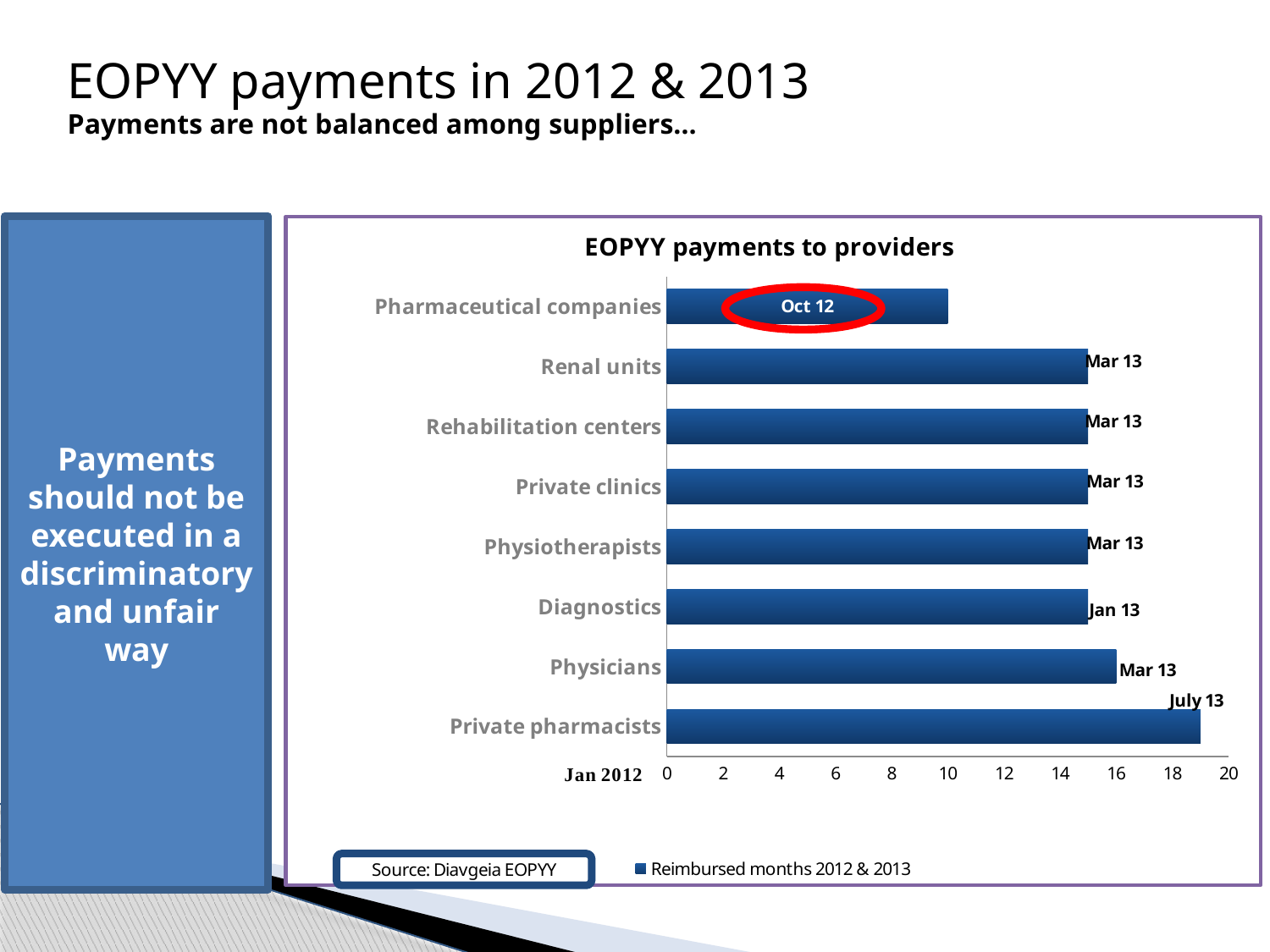
How many provider categories are shown in the chart? 8 Which provider category has the shortest bar? Pharmaceutical companies Which has a larger value, Physicians or Pharmaceutical companies? Physicians What data label is shown on the bar for Pharmaceutical companies? Oct 12 What type of chart is shown on the slide? Bar chart What is the title of the chart? EOPYY payments to providers What data label is shown on the bar for Private pharmacists? July 13 How many series does the legend list? 1 Is the value for Private pharmacists greater or less than 18? greater Which provider category has the longest bar? Private pharmacists What data label is shown on the bar for Diagnostics? Jan 13 What is the legend entry for the series in the chart? Reimbursed months 2012 & 2013